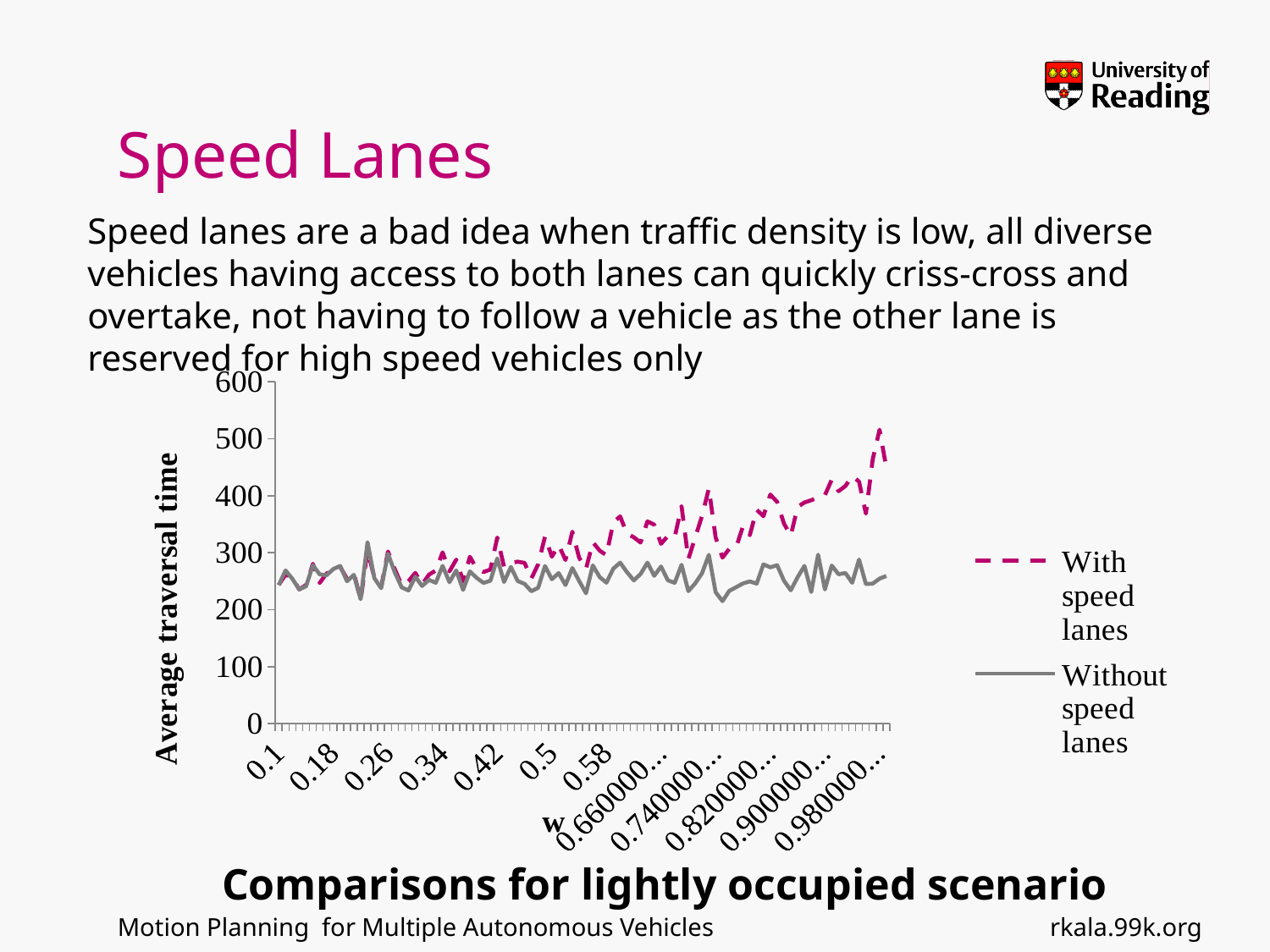
What is the highest tick value shown on the y axis? 600 What is the label of the y axis? Average traversal time Is the value for 'With speed lanes' at w = 0.1 greater or less than 400? less What kind of chart is shown on the slide? line chart Is the value for 'With speed lanes' at the far right of the chart (w near 0.98) greater or less than 400? greater Is the value for 'Without speed lanes' at the far right of the chart (w near 0.98) greater or less than 400? less Does the 'With speed lanes' series generally rise or fall as w increases along the x axis? rise At the right end of the x axis (w near 0.98), which series has the higher average traversal time: 'With speed lanes' or 'Without speed lanes'? With speed lanes How many series does the legend list? 2 What are the two series named in the legend? With speed lanes; Without speed lanes